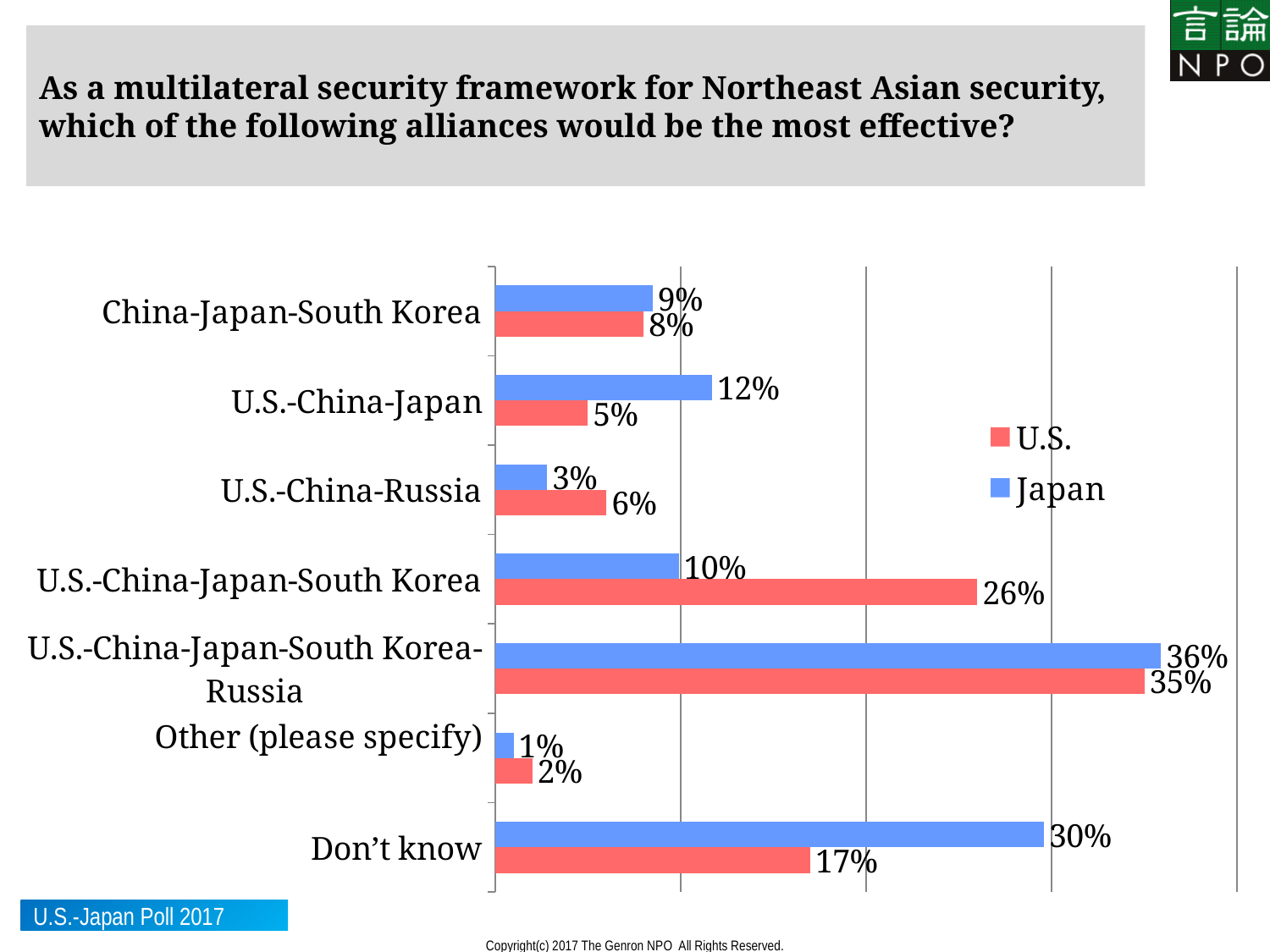
What is the difference between the U.S. and Japan values for U.S.-China-Japan-South Korea? 16% What percentage of Japanese respondents chose U.S.-China-Japan? 12% What percentage of U.S. respondents chose U.S.-China-Japan-South Korea? 26% What is the difference between the Japan and U.S. values for Don't know? 13% Which alliance received the highest share among U.S. respondents? U.S.-China-Japan-South Korea-Russia For U.S.-China-Russia, which group has the larger value, U.S. or Japan? U.S. Which category has the lowest value for Japan? Other (please specify) What type of chart is shown on the slide? Bar chart How many response categories are shown on the chart? 7 How many series does the legend list? 2 What percentage of Japanese respondents answered Don't know? 30% Which colour represents Japan in the chart? Blue